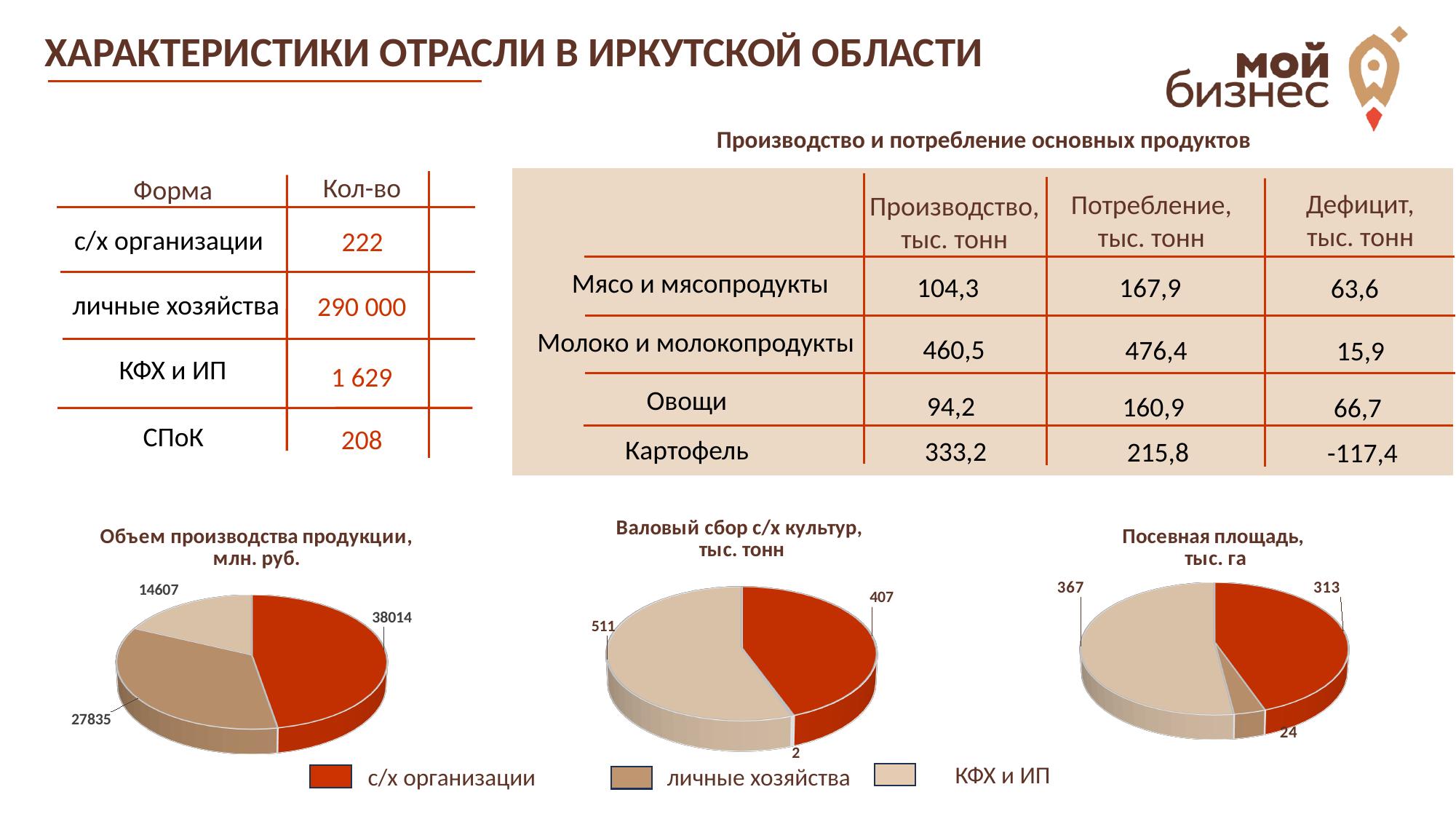
What is the total of all slices in the chart 'Валовый сбор с/х культур, тыс. тонн'? 920 What type of chart is 'Валовый сбор с/х культур, тыс. тонн'? Pie chart In the chart 'Валовый сбор с/х культур, тыс. тонн', which is larger: с/х организации or КФХ и ИП? КФХ и ИП In the chart 'Валовый сбор с/х культур, тыс. тонн', what is the value for КФХ и ИП? 511 In the chart 'Валовый сбор с/х культур, тыс. тонн', which category has the smallest slice? личные хозяйства In the chart 'Объем производства продукции, млн. руб.', which category has the largest slice? с/х организации In the chart 'Посевная площадь, тыс. га', what is the value for личные хозяйства? 24 In the chart 'Объем производства продукции, млн. руб.', what is the value for с/х организации? 38014 In the chart 'Посевная площадь, тыс. га', what is the difference between КФХ и ИП and с/х организации? 54 In the chart 'Объем производства продукции, млн. руб.', what is the difference between с/х организации and личные хозяйства? 10179 How many slices does the chart 'Посевная площадь, тыс. га' have? 3 In the chart 'Посевная площадь, тыс. га', which category has the largest slice? КФХ и ИП